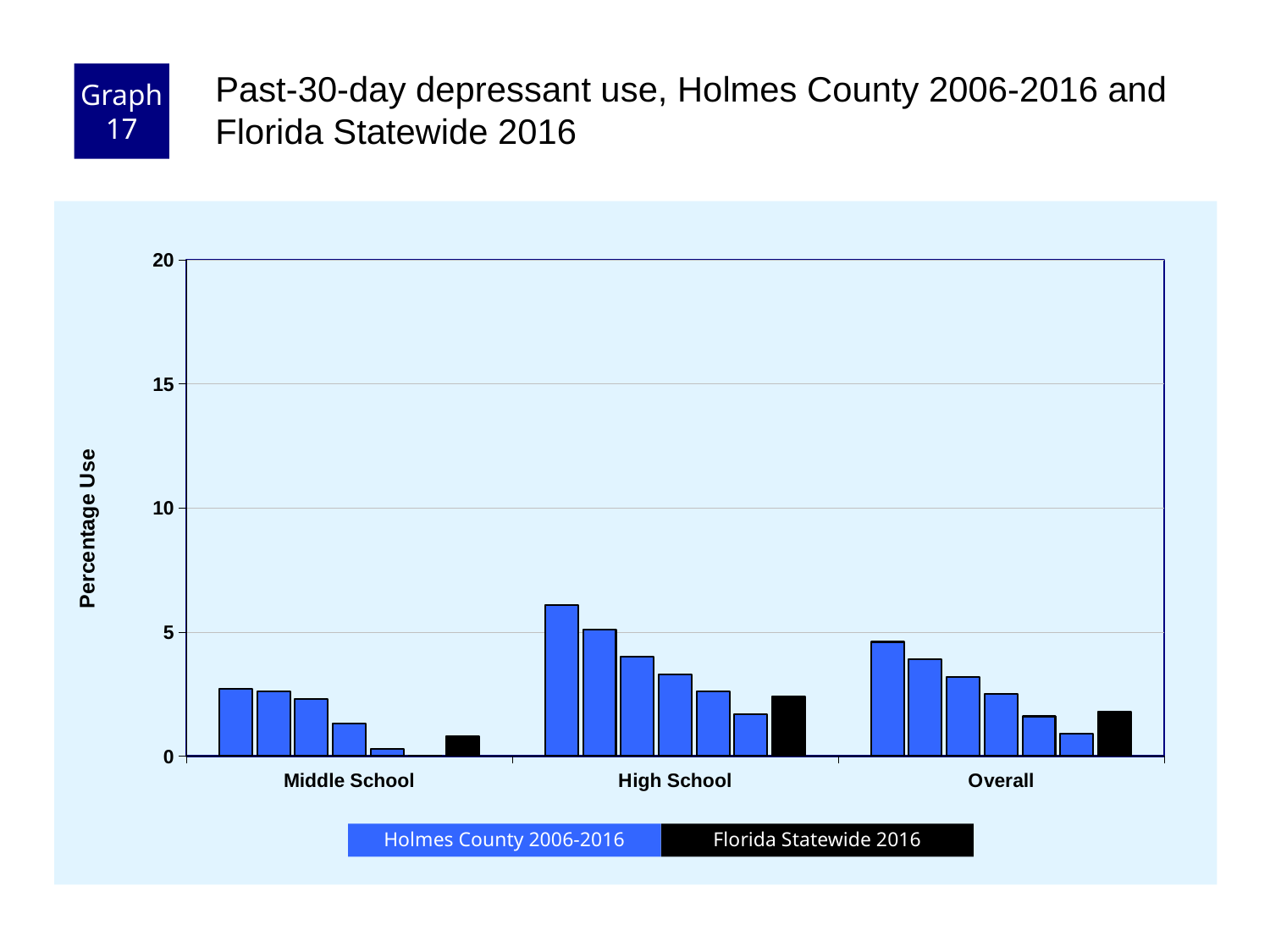
Which colour represents Florida Statewide 2016 in the legend? black What is the label on the y axis? Percentage Use Which is larger, the Florida Statewide 2016 value for High School or for Middle School? High School Within each category, do the Holmes County 2006-2016 bars rise or fall from left to right? fall How many series does the legend list? 2 Is the Florida Statewide 2016 value for Middle School greater or less than 5? less Is the tallest Holmes County bar for High School greater or less than 5? greater Is the tallest Holmes County bar for Overall greater or less than 5? less Which category has the lowest bars overall? Middle School Which category has the tallest bar overall? High School How many categories are shown on the x axis? 3 What kind of chart is shown on the slide? bar chart